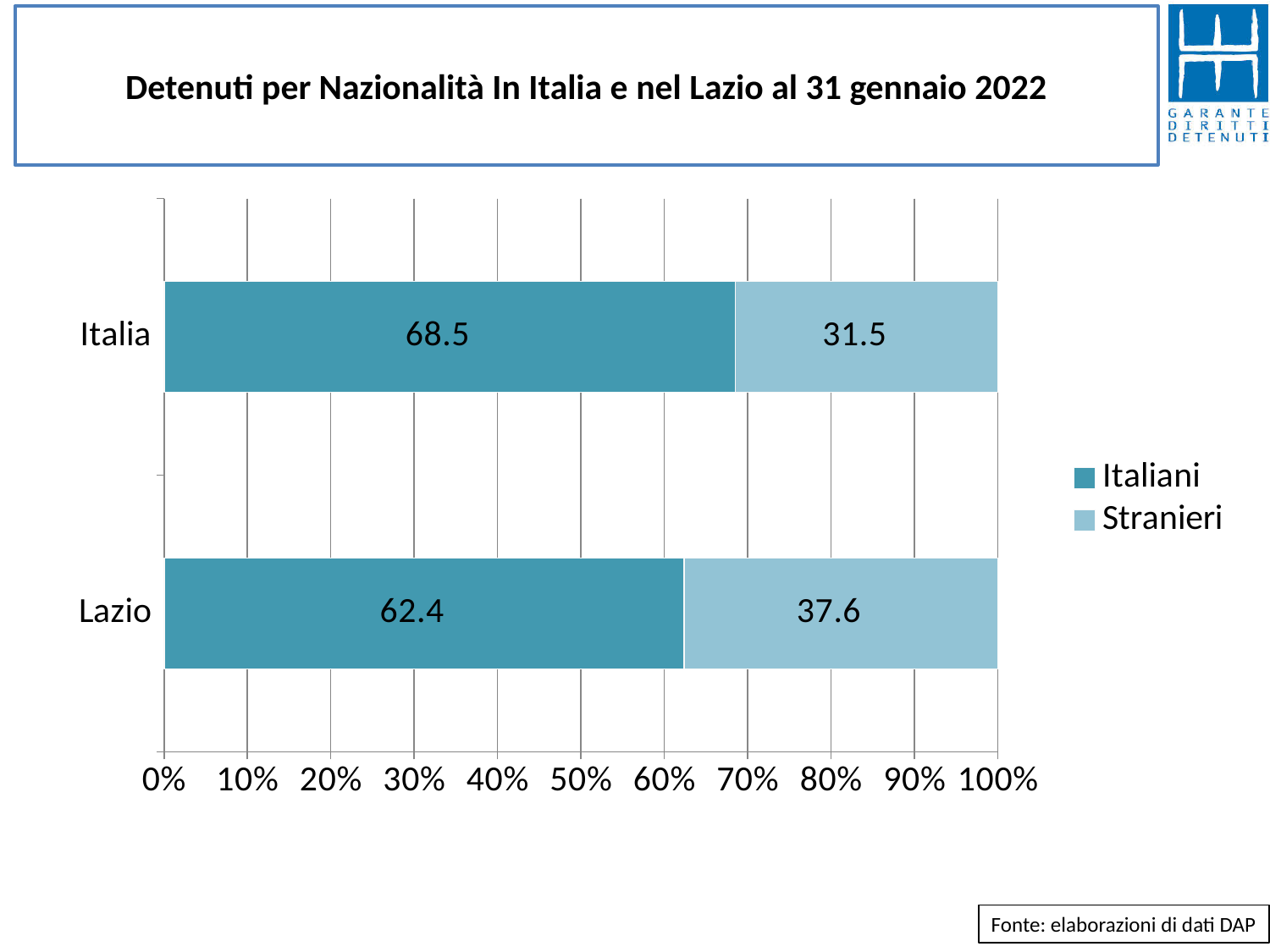
What is the difference between the Italiani values for Italia and Lazio? 6.1 How many categories are shown on the chart? 2 What is the value for Italiani in Lazio? 62.4 What is the value for Italiani in Italia? 68.5 Which category has the higher Italiani value, Italia or Lazio? Italia How many series does the legend list? 2 What kind of chart is shown on the slide? Stacked bar chart What is the value for Stranieri in Lazio? 37.6 What is the difference between the Stranieri values for Lazio and Italia? 6.1 What is the value for Stranieri in Italia? 31.5 Which category has the higher Stranieri value, Italia or Lazio? Lazio What is the title of the slide? Detenuti per Nazionalità In Italia e nel Lazio al 31 gennaio 2022